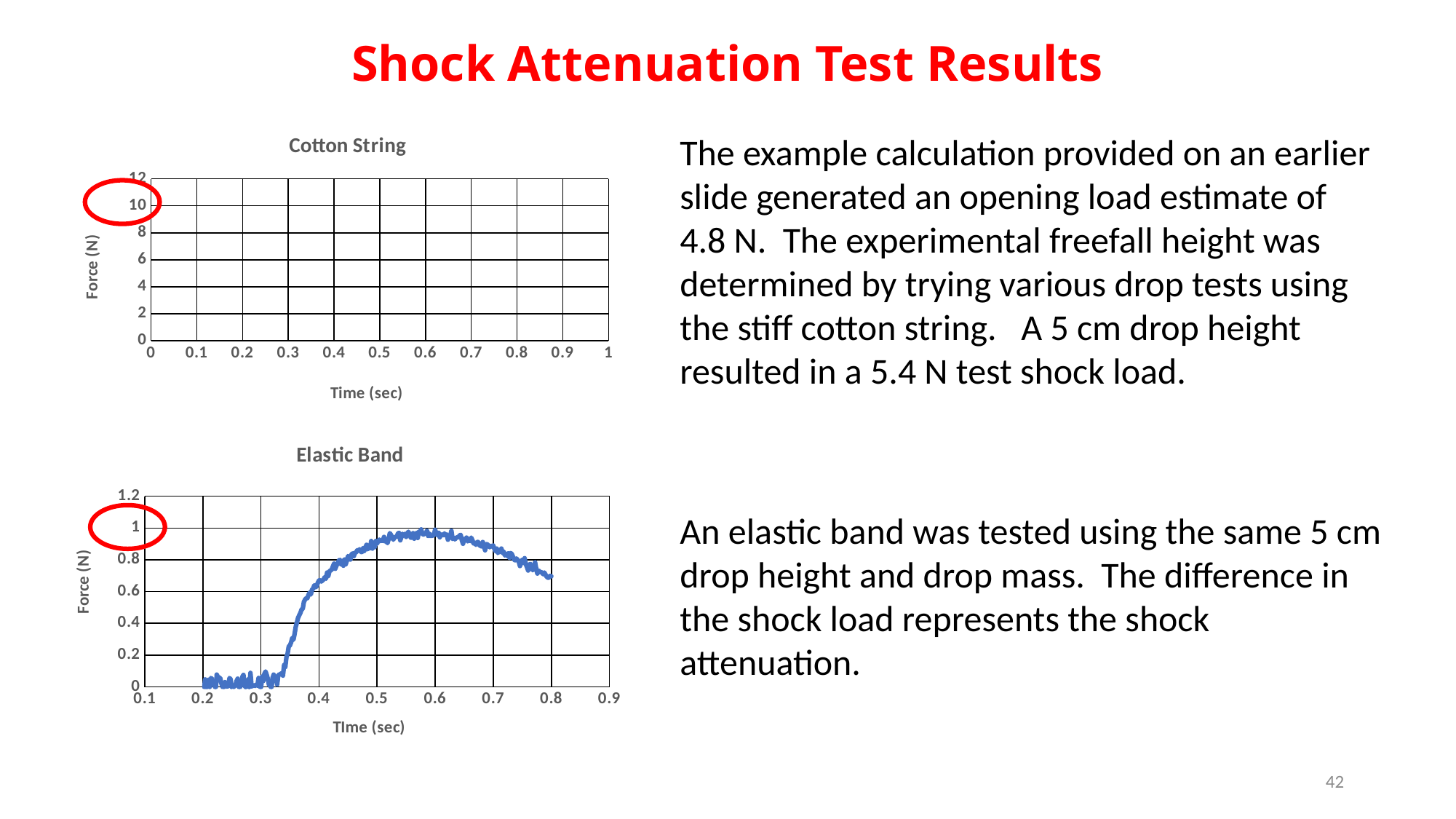
In the Elastic Band chart, does the force rise or fall between 0.6 sec and 0.8 sec? Falls In the Elastic Band chart, is the force at 0.8 sec greater or less than 0.6 N? greater In the Elastic Band chart, does the force rise or fall between 0.35 sec and 0.5 sec? Rises In the Elastic Band chart, is the force at 0.3 sec greater or less than 0.2 N? less What kind of chart is the Elastic Band chart? Line chart In the Elastic Band chart, is the force at 0.5 sec greater or less than 0.8 N? greater In the Elastic Band chart, is the force larger at 0.5 sec or at 0.3 sec? 0.5 sec How many data series are plotted in the Elastic Band chart? 1 What is the highest value shown on the y-axis of the Cotton String chart? 12 What is the y-axis title of the Cotton String chart? Force (N) In the Elastic Band chart, is the force larger at 0.6 sec or at 0.8 sec? 0.6 sec